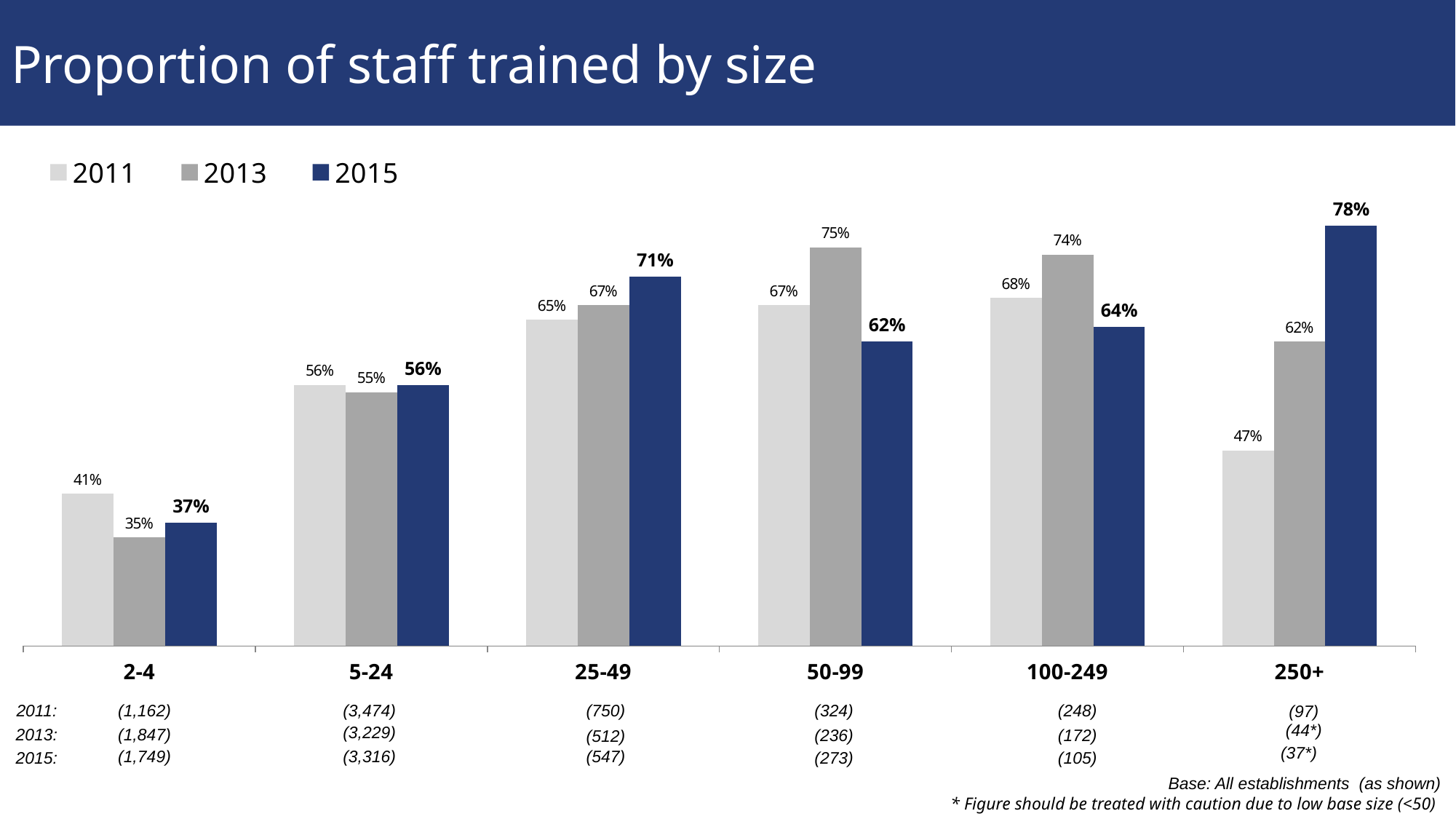
What is the proportion of staff trained in 2015 for establishments of size 250+? 78% What is the title of the chart? Proportion of staff trained by size What is the difference between the 2015 and 2011 values for the 250+ size band? 31 percentage points What is the proportion of staff trained in 2013 for establishments of size 2-4? 35% What is the difference between the 2013 and 2015 values for the 100-249 size band? 10 percentage points For the 50-99 size band, which year has the larger proportion of staff trained: 2013 or 2015? 2013 How many size bands are shown on the x axis? 6 Which size band has the highest proportion of staff trained in 2015? 250+ Which size band has the lowest proportion of staff trained in 2011? 2-4 How many series does the legend list? 3 What is the proportion of staff trained in 2011 for establishments of size 100-249? 68% What kind of chart is shown on the slide? Bar chart